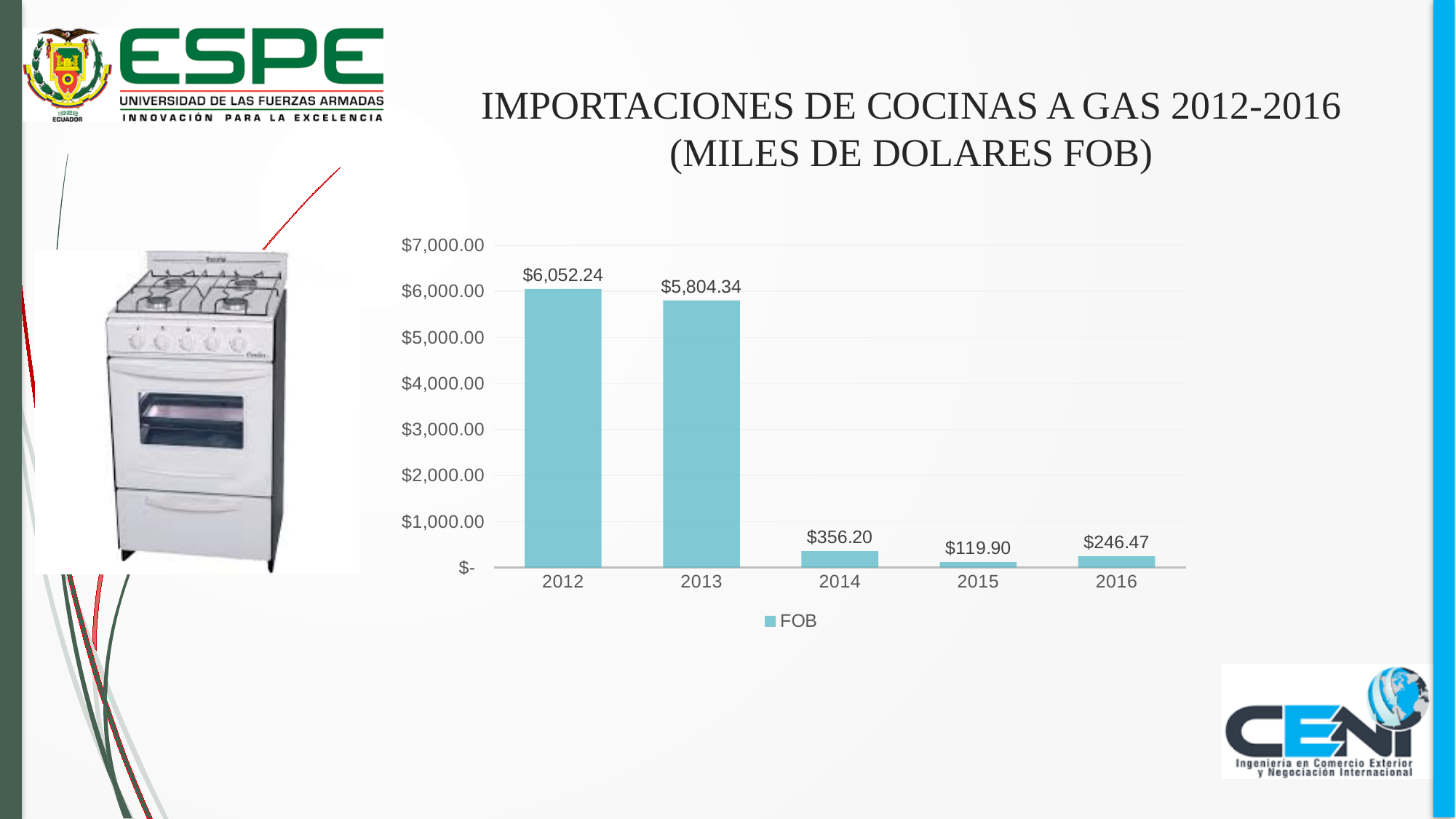
What is the name of the series listed in the legend? FOB What is the difference between the FOB values for 2014 and 2016? $109.73 Is the FOB value for 2013 greater or less than $5,000.00? greater Which year has a larger FOB value, 2014 or 2016? 2014 What is the difference between the FOB values for 2012 and 2013? $247.90 Which year has the highest FOB value? 2012 Which year has the lowest FOB value? 2015 What kind of chart is shown on the slide? bar chart What is the FOB value for 2012? $6,052.24 What is the FOB value for 2015? $119.90 How many years are shown on the x axis? 5 What is the FOB value for 2016? $246.47